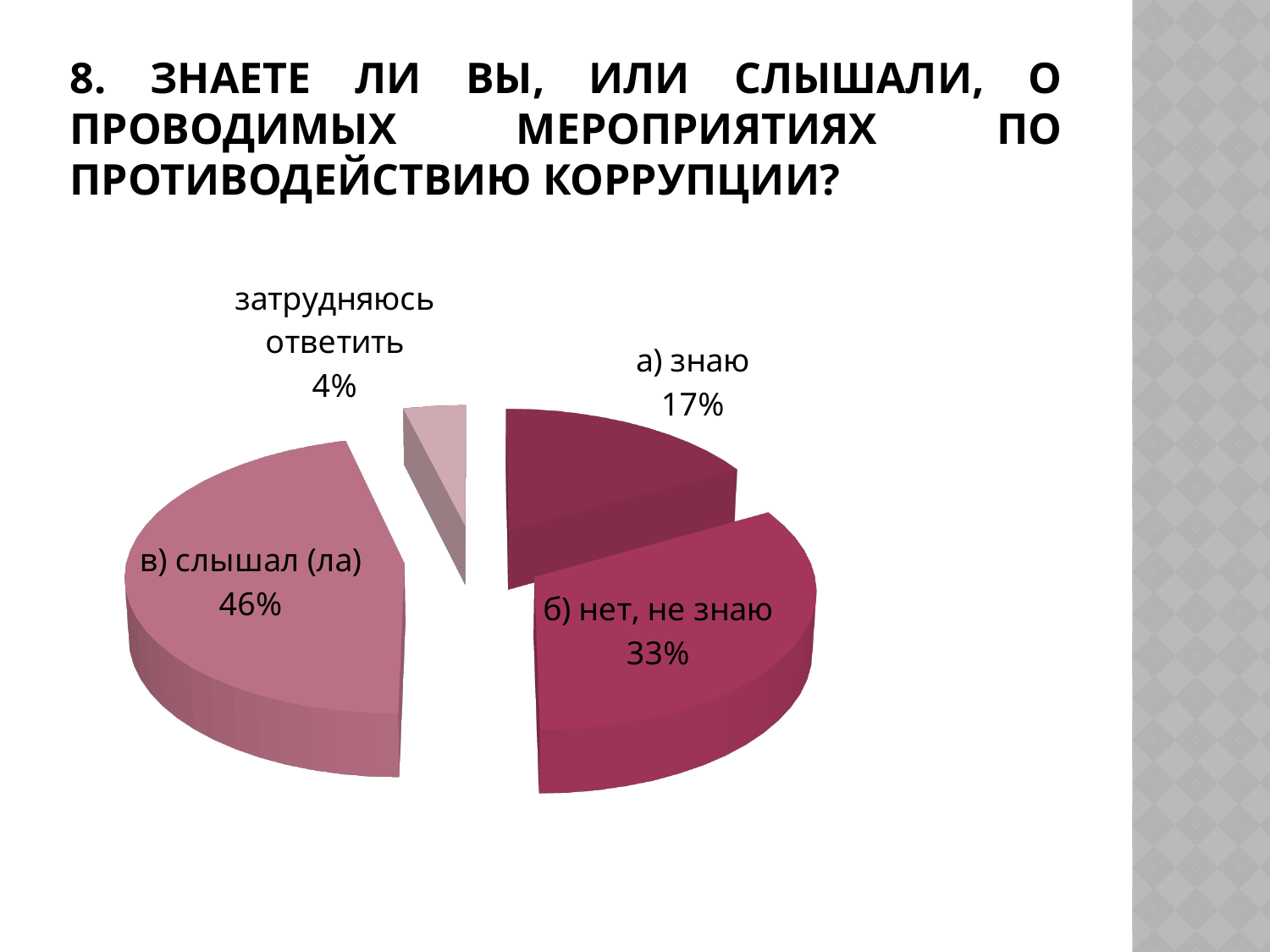
What type of chart is shown on the slide? Pie chart What is the difference in percentage points between "в) слышал (ла)" and "б) нет, не знаю"? 13 What share of respondents answered "а) знаю"? 17% What share of respondents answered "затрудняюсь ответить"? 4% What share of respondents answered "в) слышал (ла)"? 46% What share of respondents answered "б) нет, не знаю"? 33% What is the combined share of "а) знаю" and "в) слышал (ла)"? 63% What is the difference in percentage points between "а) знаю" and "затрудняюсь ответить"? 13 Which is larger: the share for "а) знаю" or the share for "б) нет, не знаю"? б) нет, не знаю How many slices does the pie chart have? 4 Which answer option has the largest share of the pie? в) слышал (ла) Which answer option has the smallest share of the pie? затрудняюсь ответить